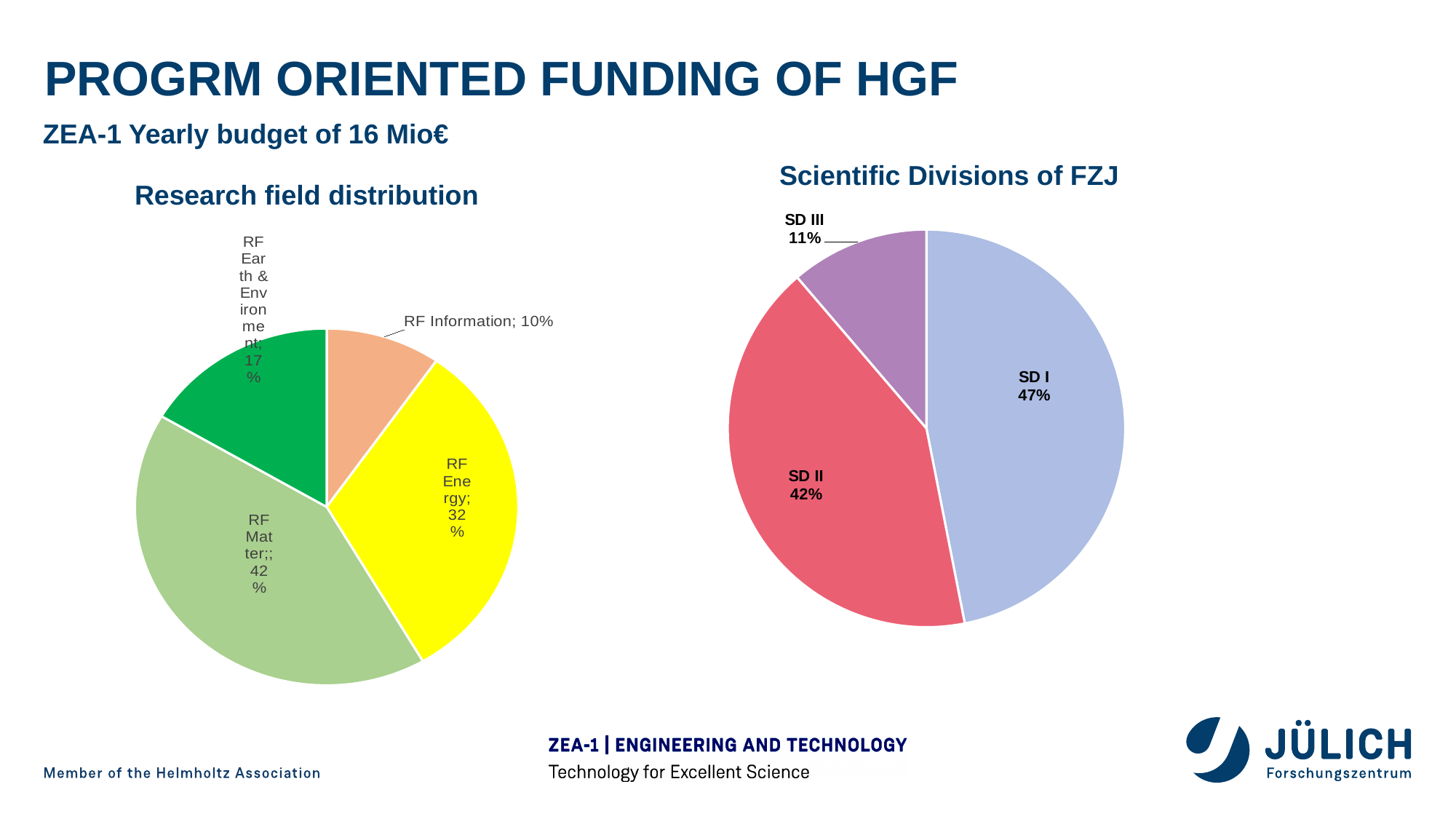
In the 'Scientific Divisions of FZJ' chart, which division has the smallest share? SD III In the 'Research field distribution' chart, what share does RF Information have? 10% In the 'Scientific Divisions of FZJ' chart, what is the difference in percentage points between SD I and SD III? 36 In the 'Research field distribution' chart, how many slices does the pie have? 4 In the 'Scientific Divisions of FZJ' chart, what colour is the SD II slice? Red In the 'Research field distribution' chart, which research field has the largest share? RF Matter In the 'Research field distribution' chart, what share does RF Energy have? 32% What type of chart is the 'Scientific Divisions of FZJ' chart? Pie chart In the 'Scientific Divisions of FZJ' chart, which division has the largest share? SD I In the 'Scientific Divisions of FZJ' chart, what share does SD II have? 42% In the 'Research field distribution' chart, what is the difference in percentage points between RF Matter and RF Energy? 10 In the 'Research field distribution' chart, which research field has the smallest share? RF Information